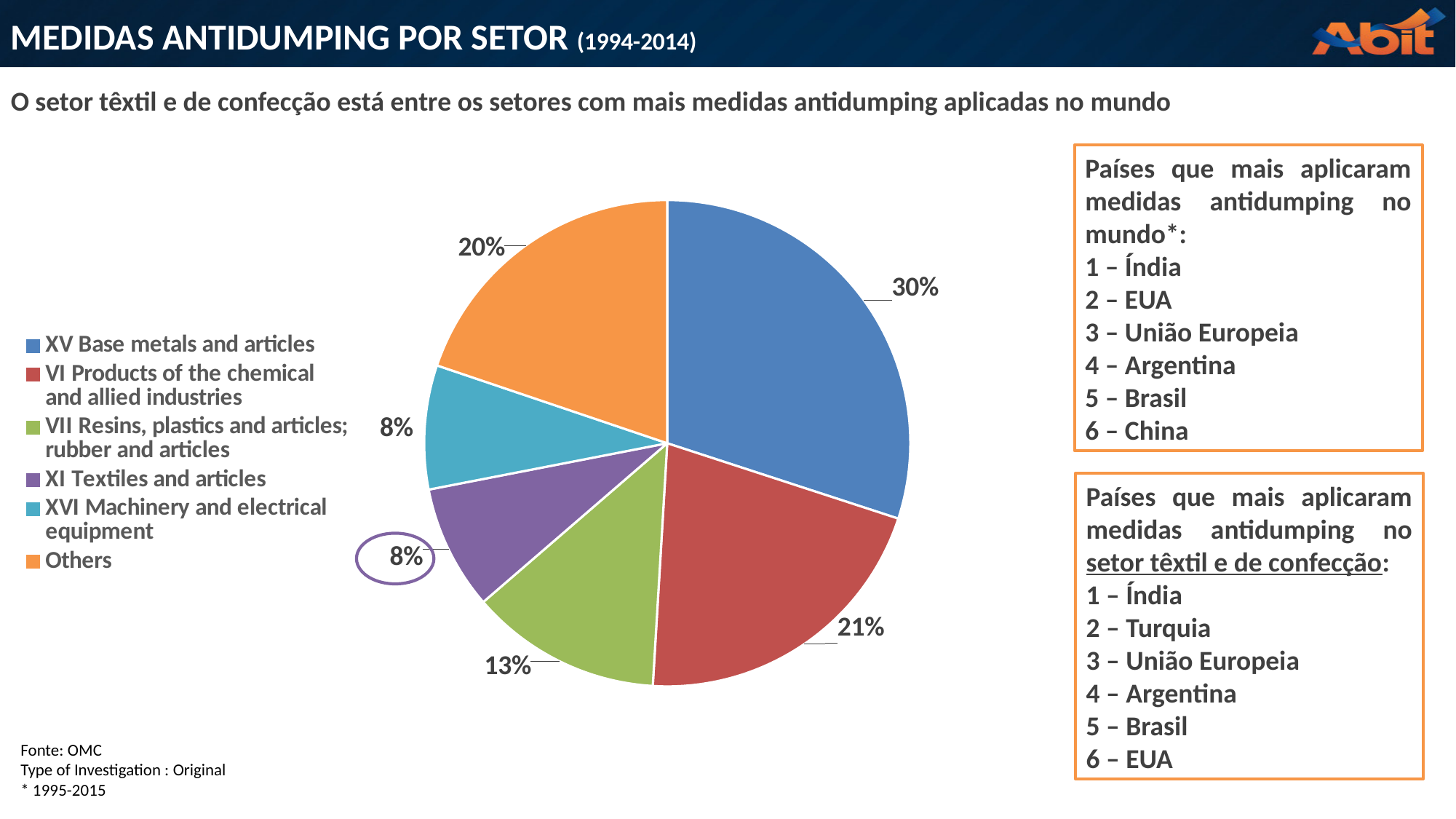
What kind of chart is shown on the slide? pie chart What is the value shown for 'VI Products of the chemical and allied industries'? 21% What is the value shown for 'Others'? 20% What share of the pie does 'XI Textiles and articles' hold? 8% What is the combined share of 'XI Textiles and articles' and 'XVI Machinery and electrical equipment'? 16% What colour is the slice for 'XI Textiles and articles'? purple What is the value shown for 'VII Resins, plastics and articles; rubber and articles'? 13% What is the difference in percentage points between 'XV Base metals and articles' and 'VI Products of the chemical and allied industries'? 9 percentage points Which category has the largest slice of the pie? XV Base metals and articles Which is larger: the slice for 'Others' or the slice for 'VII Resins, plastics and articles; rubber and articles'? Others How many slices does the pie chart have? 6 What share of the pie does 'XV Base metals and articles' hold? 30%